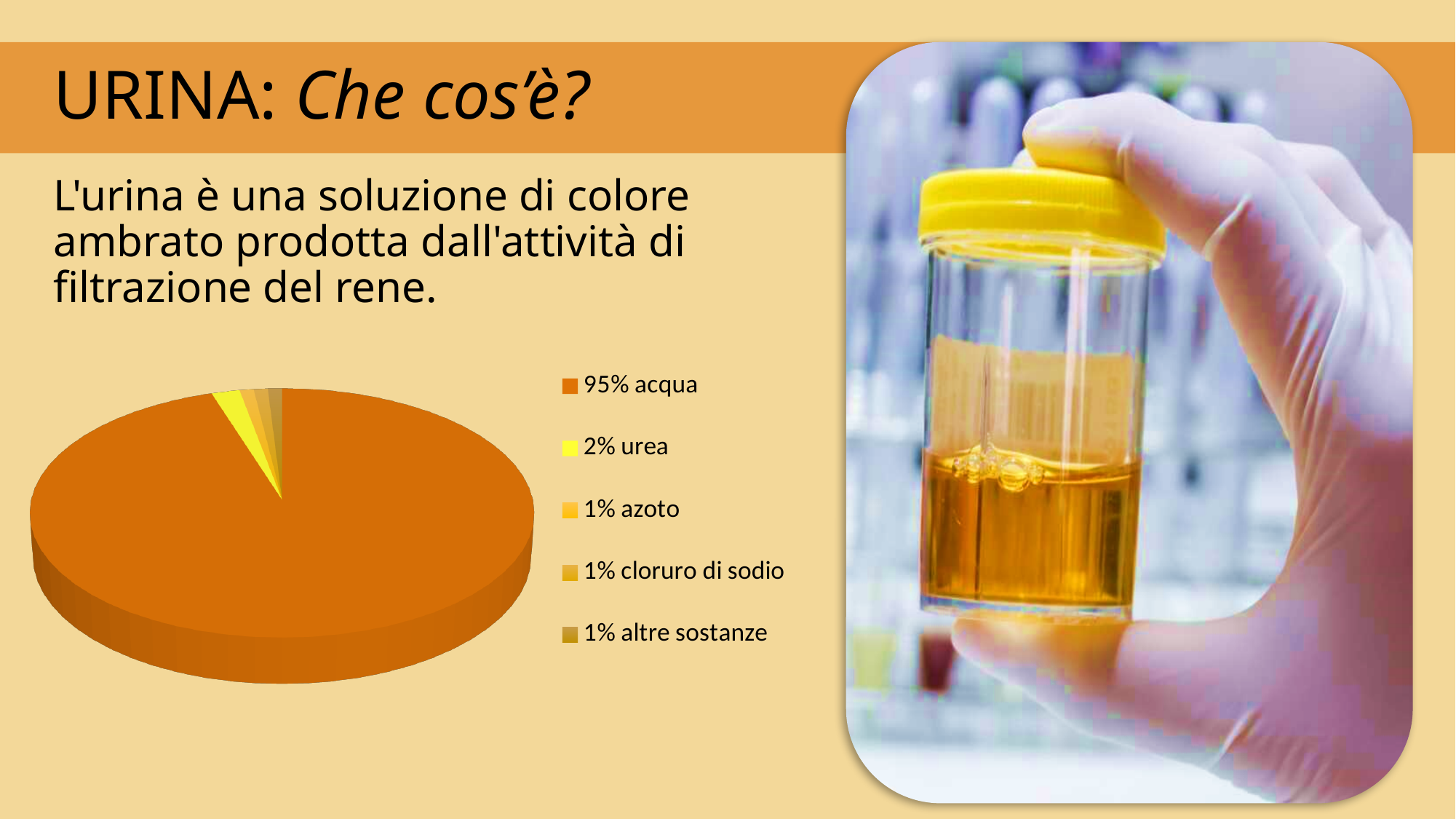
What colour is the slice for acqua in the pie chart? orange Which is larger, the share for acqua or the share for urea? acqua What share of the pie does acqua represent? 95% What share of the pie does azoto represent? 1% Which category has the largest slice of the pie? acqua How many categories does the pie chart show? 5 What is the difference between the share for acqua and the share for urea? 93% What share of the pie does urea represent? 2% What kind of chart is shown on the slide? pie chart What is the total of all the shares listed in the legend? 100% Which is larger, the share for urea or the share for azoto? urea